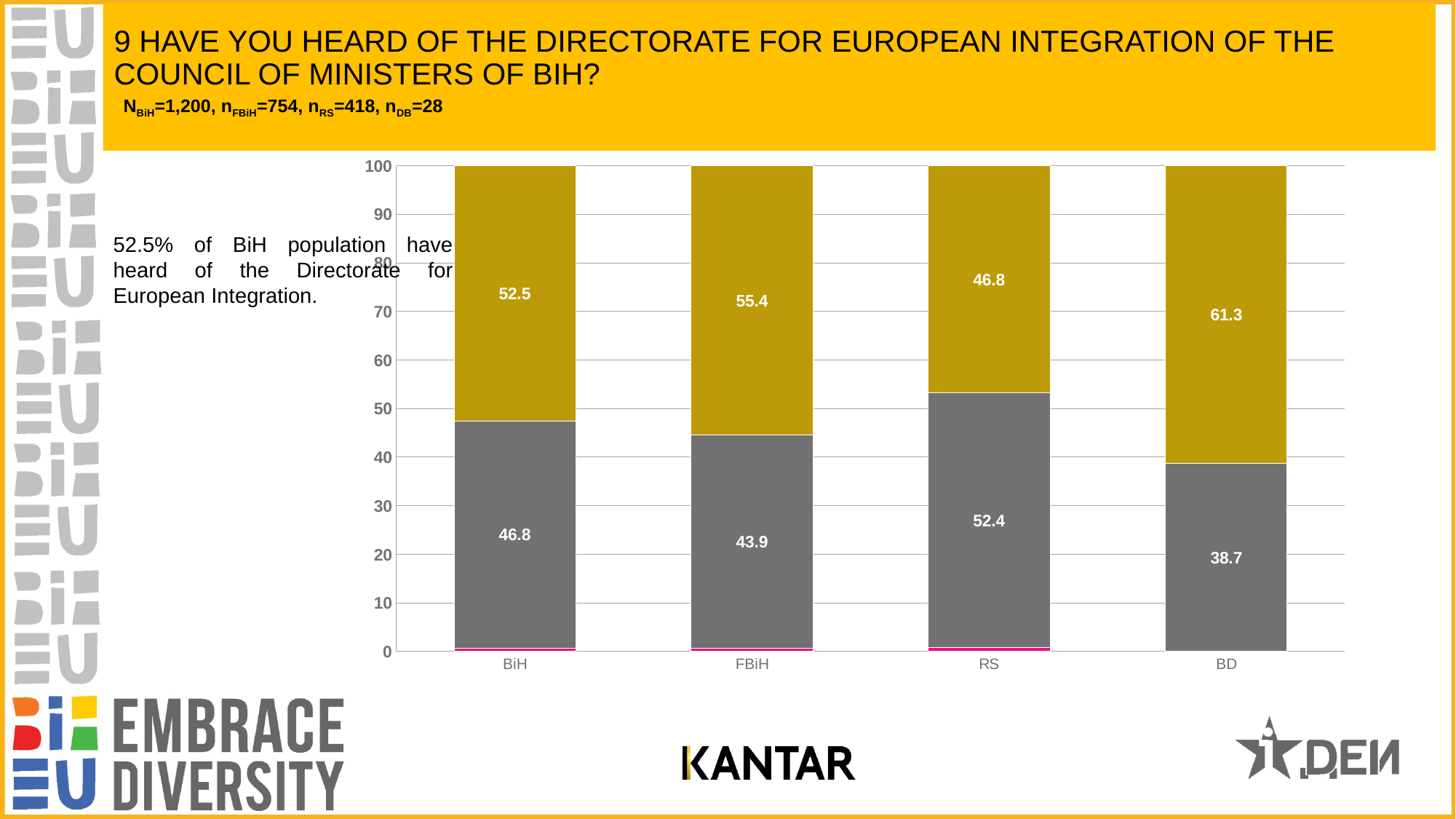
What are the category labels on the x axis, from left to right? BiH, FBiH, RS, BD What kind of chart is shown on the slide? Stacked bar chart Which category has the smallest gray (lower) segment? BD Which category has the largest gray (lower) segment? RS What is the value of the gold (upper) segment for BD? 61.3 How many categories are shown on the x axis of the chart? 4 Which category has the largest gold (upper) segment? BD What is the difference between the gold segment values for BD and RS? 14.5 What is the value of the gold (upper) segment for BiH? 52.5 Which has the larger gold (upper) segment, BiH or FBiH? FBiH What is the value of the gray (lower) segment for RS? 52.4 Which category has the smallest gold (upper) segment? RS